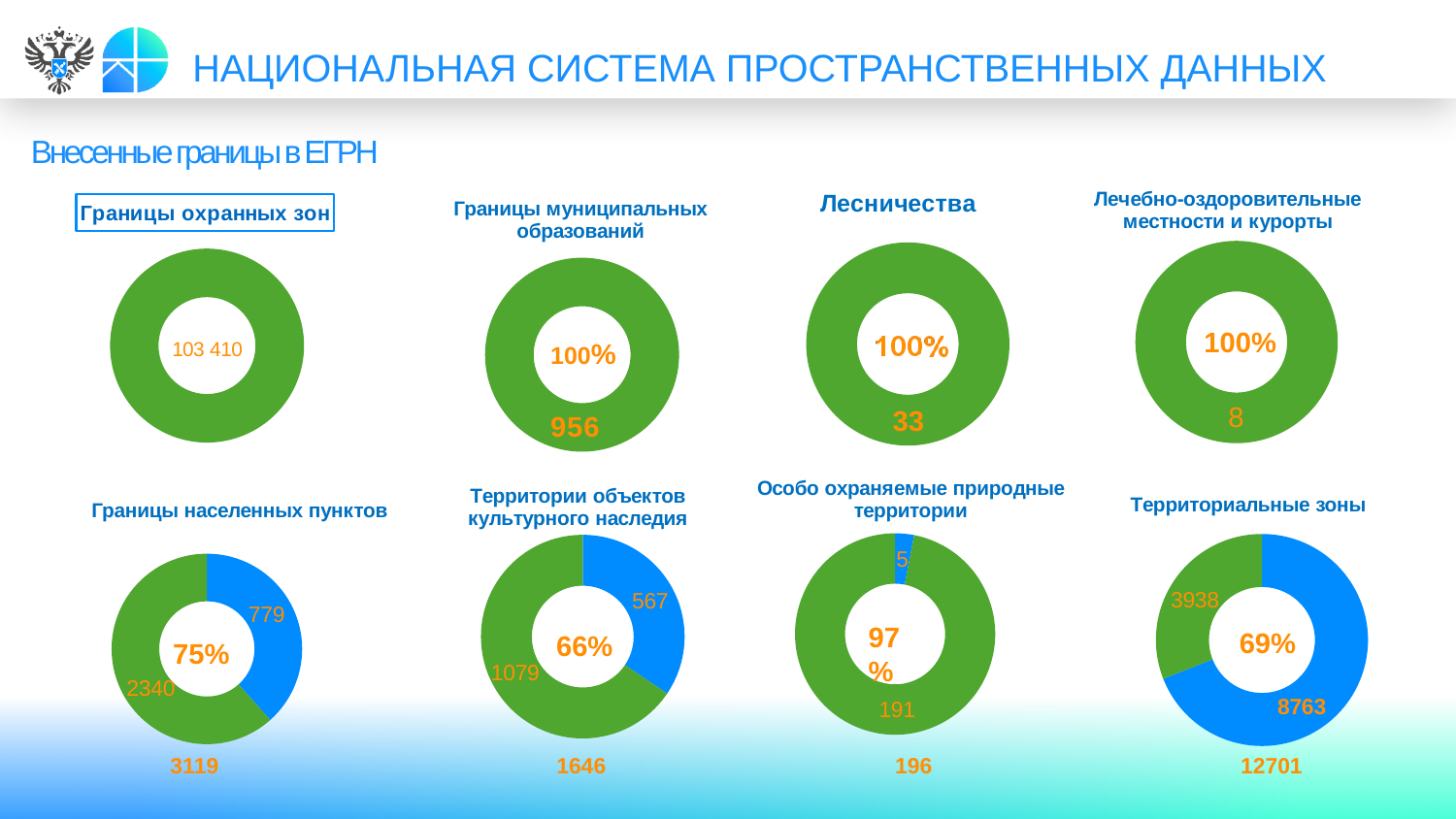
In the 'Границы охранных зон' chart, what value is printed in the centre? 103 410 In the 'Границы населенных пунктов' chart, what is the difference between the green segment (2340) and the blue segment (779)? 1561 In the 'Территориальные зоны' chart, what is the value of the blue segment? 8763 How many donut charts are shown on the slide? 8 In the 'Лесничества' chart, what percentage is shown in the centre? 100% In the 'Границы населенных пунктов' chart, what is the value of the blue segment? 779 In the 'Территориальные зоны' chart, what percentage is shown in the centre? 69% In the 'Границы муниципальных образований' chart, what number is printed on the green ring? 956 In the 'Особо охраняемые природные территории' chart, what total is printed below the chart? 196 What kind of chart is used for 'Границы населенных пунктов'? donut (pie) chart In the 'Лечебно-оздоровительные местности и курорты' chart, what number is printed on the ring? 8 In the 'Территории объектов культурного наследия' chart, which segment is larger, the green (1079) or the blue (567)? green (1079)